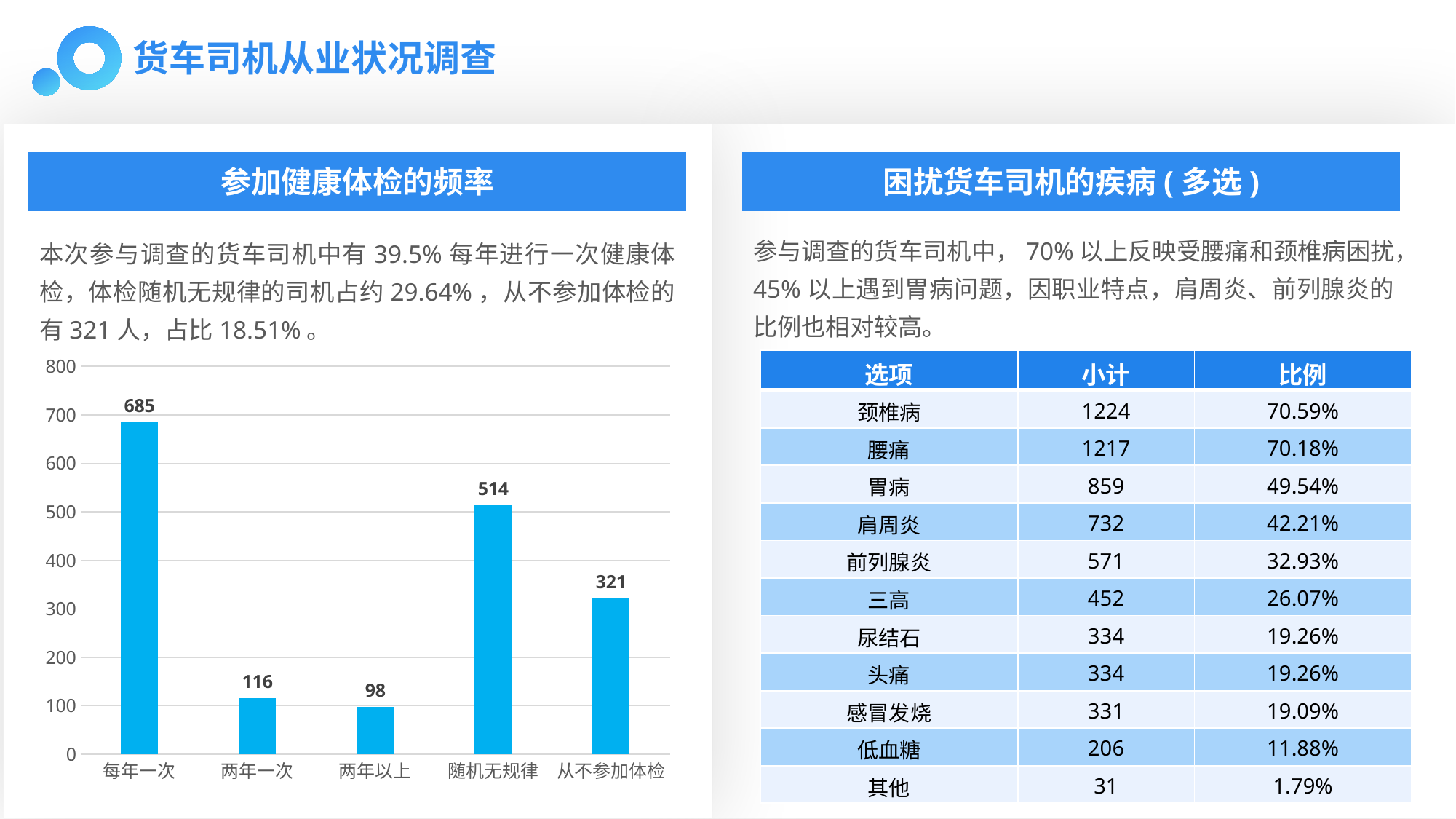
In the bar chart, what is the difference between the values for 每年一次 and 随机无规律? 171 In the bar chart, what is the value for 随机无规律? 514 Which category has the lowest value in the bar chart? 两年以上 In the bar chart, what is the value for 两年以上? 98 In the bar chart, what is the difference between the values for 两年一次 and 两年以上? 18 What type of chart is shown under the heading 参加健康体检的频率? bar chart In the bar chart, what is the value for 从不参加体检? 321 In the bar chart, is the value for 随机无规律 greater or less than 500? greater How many categories are shown in the bar chart? 5 Which category has the highest value in the bar chart? 每年一次 In the bar chart, which is larger: the value for 从不参加体检 or the value for 两年一次? 从不参加体检 In the bar chart, what is the value for 每年一次? 685